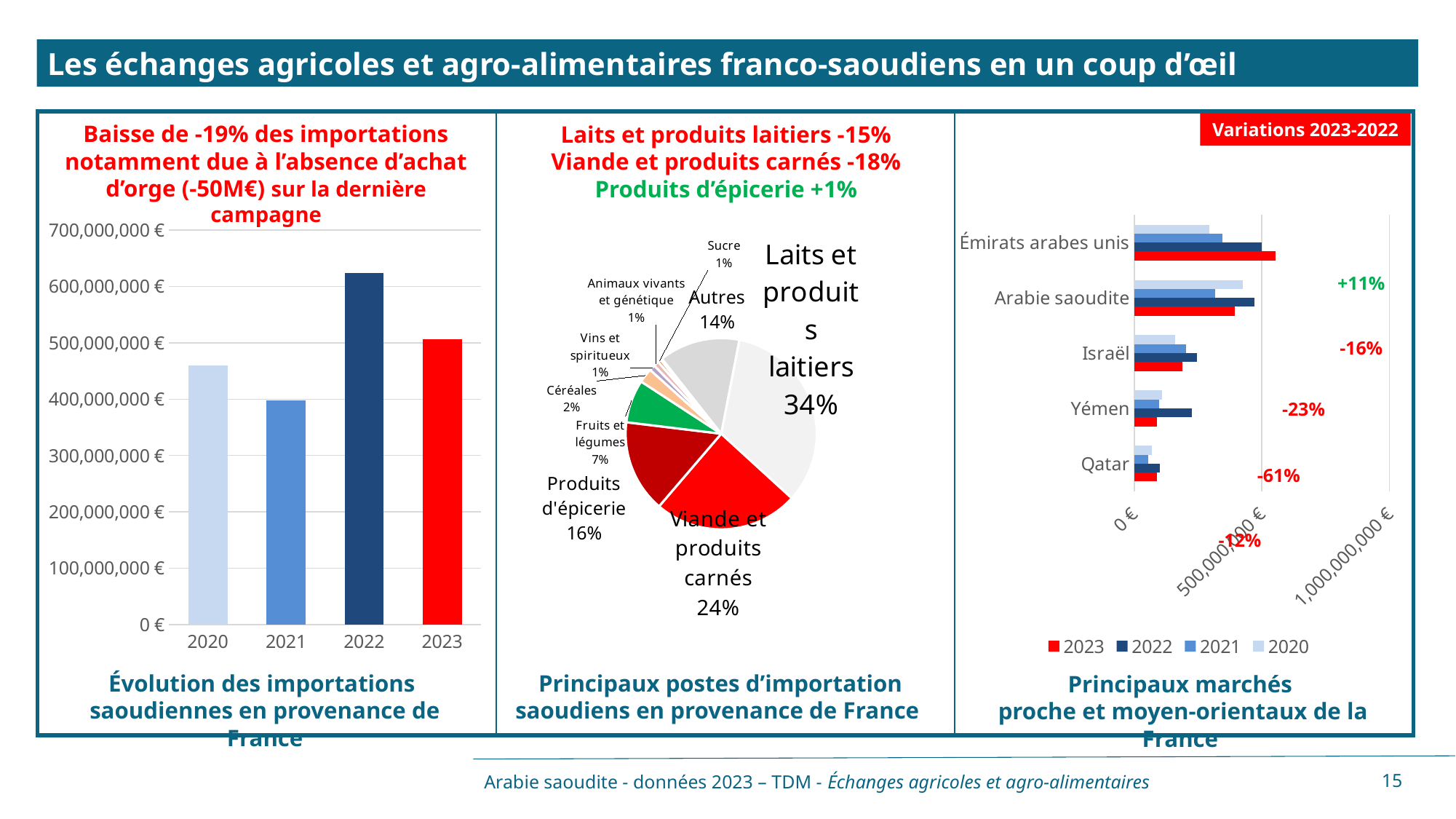
In the right chart 'Principaux marchés proche et moyen-orientaux de la France', how many series does the legend list? 4 In the middle pie chart 'Principaux postes d'importation saoudiens en provenance de France', what share does 'Viande et produits carnés' have? 24% In the left chart 'Évolution des importations saoudiennes en provenance de France', is the value for 2022 greater or less than 600,000,000 €? greater In the left chart 'Évolution des importations saoudiennes en provenance de France', which year has the lowest value? 2021 What kind of chart is the left chart, 'Évolution des importations saoudiennes en provenance de France'? bar chart In the middle pie chart 'Principaux postes d'importation saoudiens en provenance de France', how many slices are there? 9 In the right chart 'Principaux marchés proche et moyen-orientaux de la France', is the 2023 value for Émirats arabes unis greater or less than 500,000,000 €? greater In the middle pie chart 'Principaux postes d'importation saoudiens en provenance de France', what is the difference in percentage points between 'Produits d'épicerie' and 'Fruits et légumes'? 9 In the left chart 'Évolution des importations saoudiennes en provenance de France', which year has the highest value? 2022 In the left chart 'Évolution des importations saoudiennes en provenance de France', how many years are plotted? 4 In the middle pie chart 'Principaux postes d'importation saoudiens en provenance de France', what share does 'Laits et produits laitiers' have? 34%